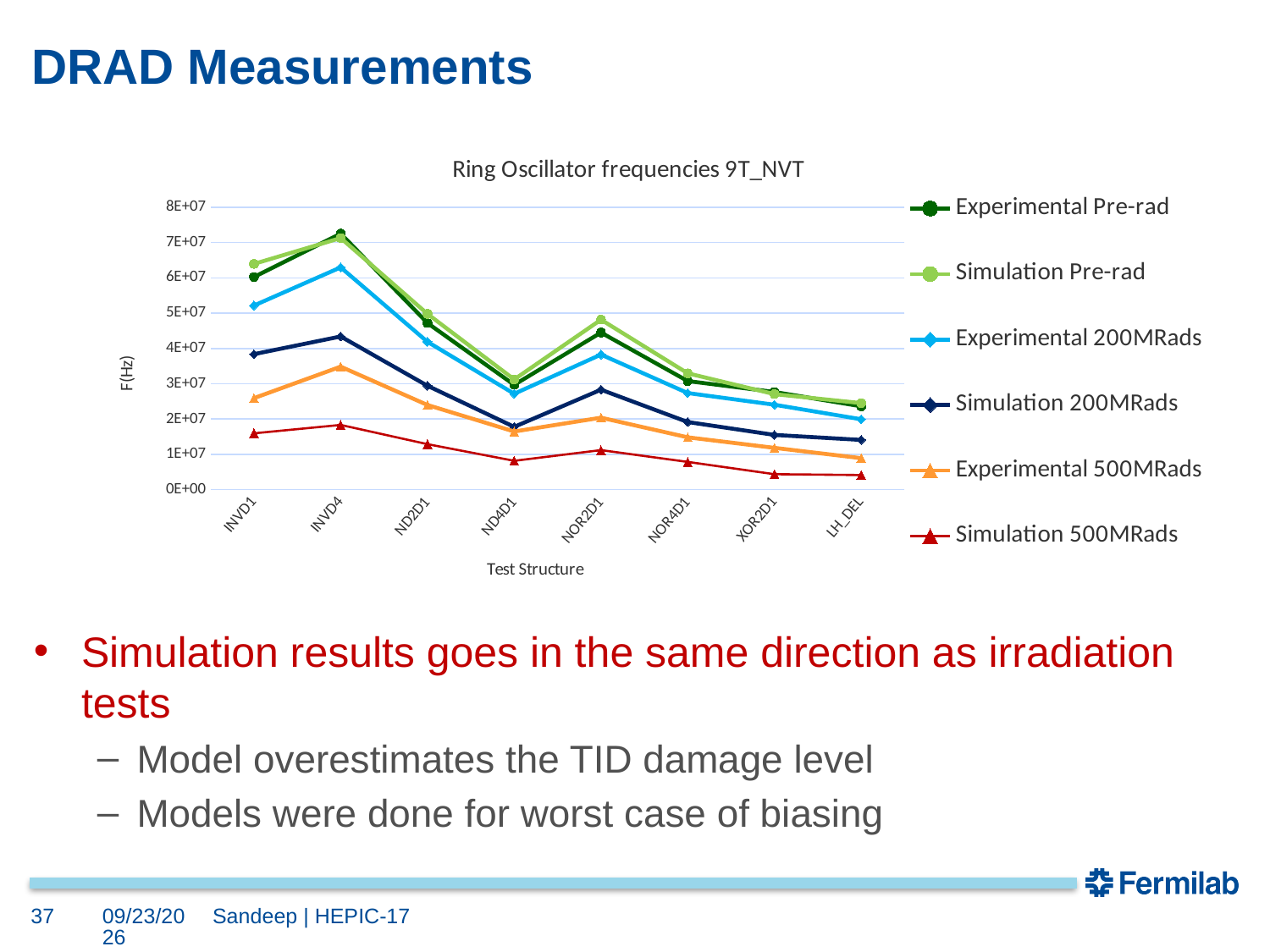
What is the label of the y axis? F(Hz) Do the Simulation 500MRads values rise or fall from NOR2D1 to LH_DEL? fall Which test structure has the highest Experimental Pre-rad frequency? INVD4 Is the Simulation 200MRads value for INVD1 greater or less than 3E+07? greater What is the title of the chart? Ring Oscillator frequencies 9T_NVT How many test structures are plotted along the x axis? 8 Is the Simulation 500MRads value for LH_DEL greater or less than 1E+07? less At NOR2D1, which is larger: the Simulation 200MRads value or the Experimental 500MRads value? Simulation 200MRads What kind of chart is shown on the slide? Line chart Is the Experimental Pre-rad value for INVD4 greater or less than 6E+07? greater How many series does the legend list? 6